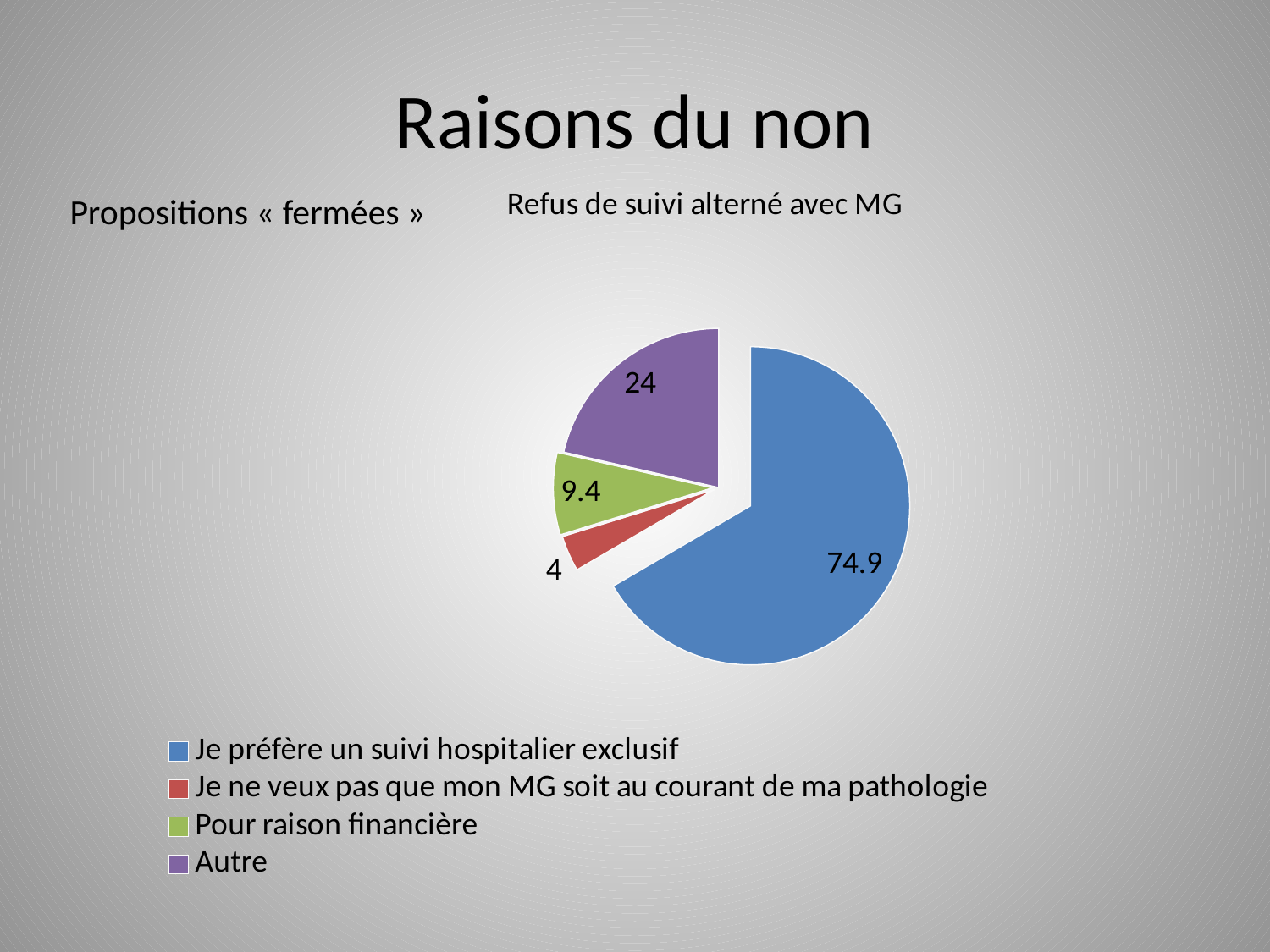
What is the value for "Je préfère un suivi hospitalier exclusif"? 74.9 How many categories does the pie chart have? 4 What is the title of the chart? Refus de suivi alterné avec MG What is the difference between the values for "Autre" and "Pour raison financière"? 14.6 What colour is the slice for "Autre"? Purple What kind of chart is shown on the slide? Pie chart Which is larger, the value for "Autre" or the value for "Pour raison financière"? Autre What is the value for "Pour raison financière"? 9.4 What is the value for "Autre"? 24 Which category has the smallest slice? Je ne veux pas que mon MG soit au courant de ma pathologie What is the value for "Je ne veux pas que mon MG soit au courant de ma pathologie"? 4 Which category has the largest slice? Je préfère un suivi hospitalier exclusif